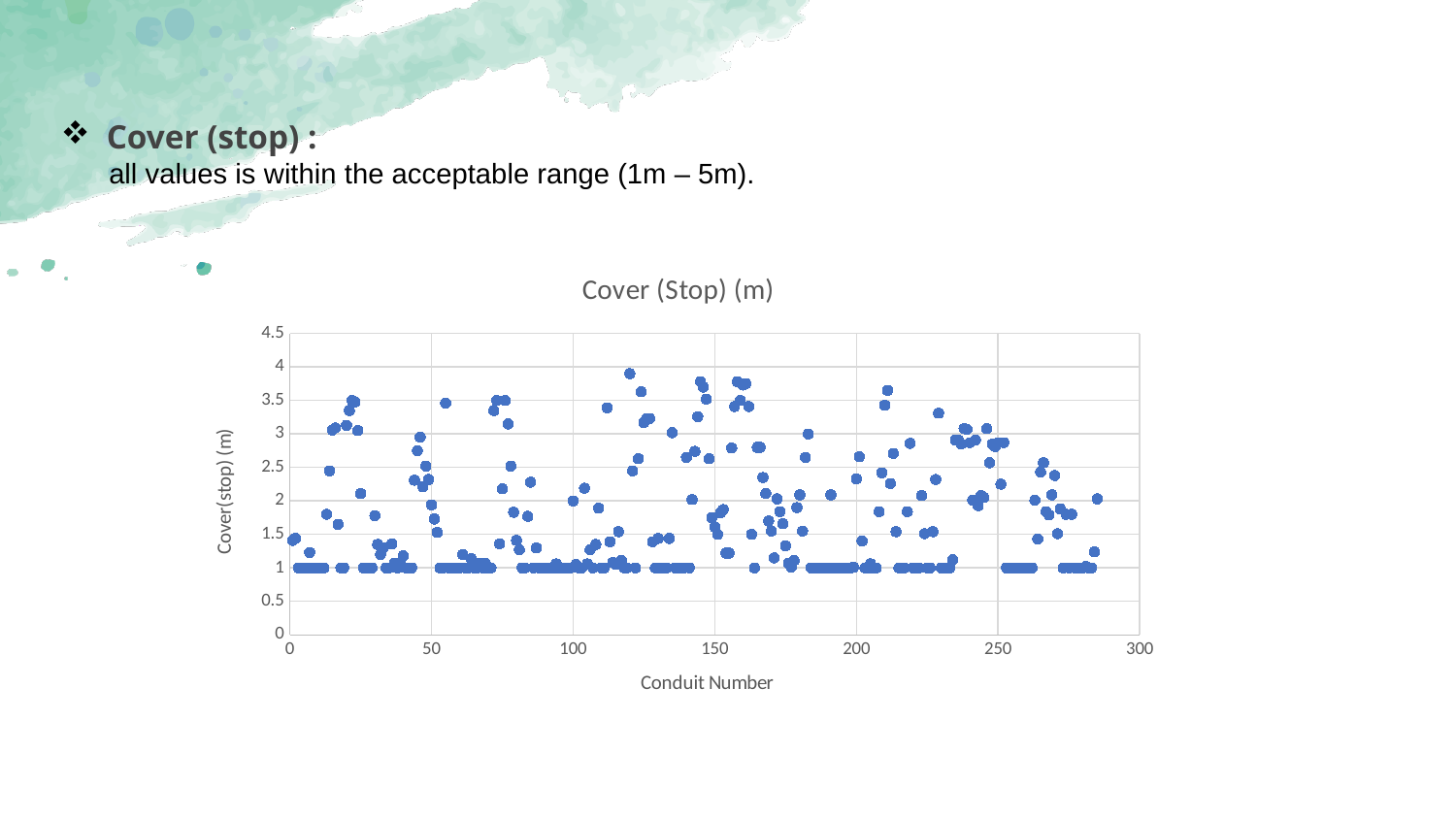
What is the title of the chart? Cover (Stop) (m) What kind of chart is shown on the slide? scatter chart Is the highest plotted value on the chart greater or less than 3.5? greater Is the lowest plotted value on the chart greater or less than 0.5? greater Is the highest plotted value on the chart greater or less than 4? less What is the label of the x axis of the chart? Conduit Number